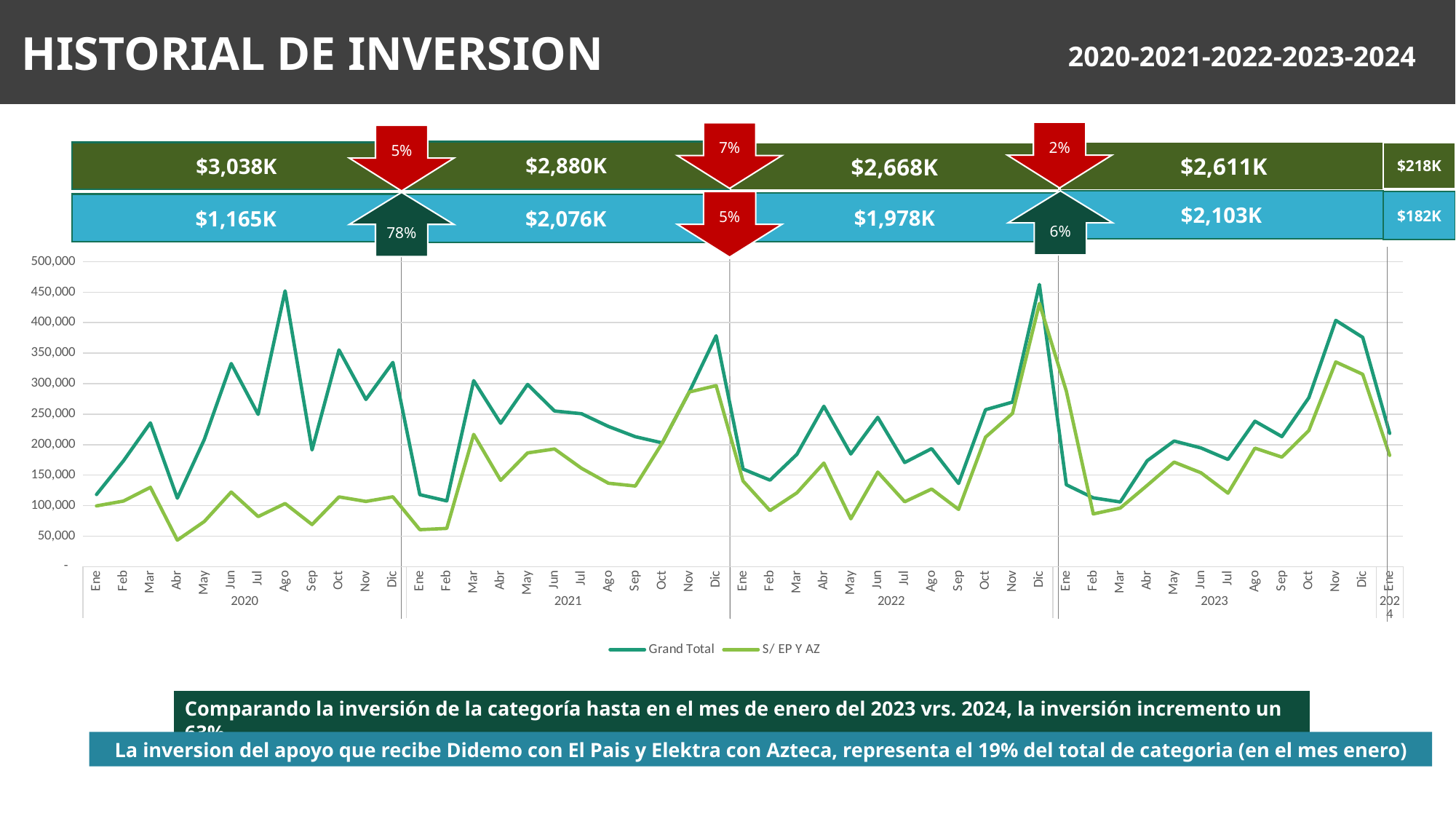
What are the names of the two series in the chart legend? Grand Total and S/ EP Y AZ Is the S/ EP Y AZ value for Abr 2020 greater or less than 50,000? less Which is larger for Grand Total: the value in Ago 2020 or the value in Feb 2021? Ago 2020 Is the Grand Total value for Ago 2020 greater or less than 400,000? greater What kind of chart is shown on the slide? line chart Is the S/ EP Y AZ value for Ene 2021 greater or less than 100,000? less In which month and year does the S/ EP Y AZ series reach its highest value? Dic 2022 In which month and year does the S/ EP Y AZ series reach its lowest value? Abr 2020 How many series does the chart legend list? 2 How many years are labelled along the x axis of the chart? 5 Does the Grand Total series rise or fall from Nov 2023 to Ene 2024? fall